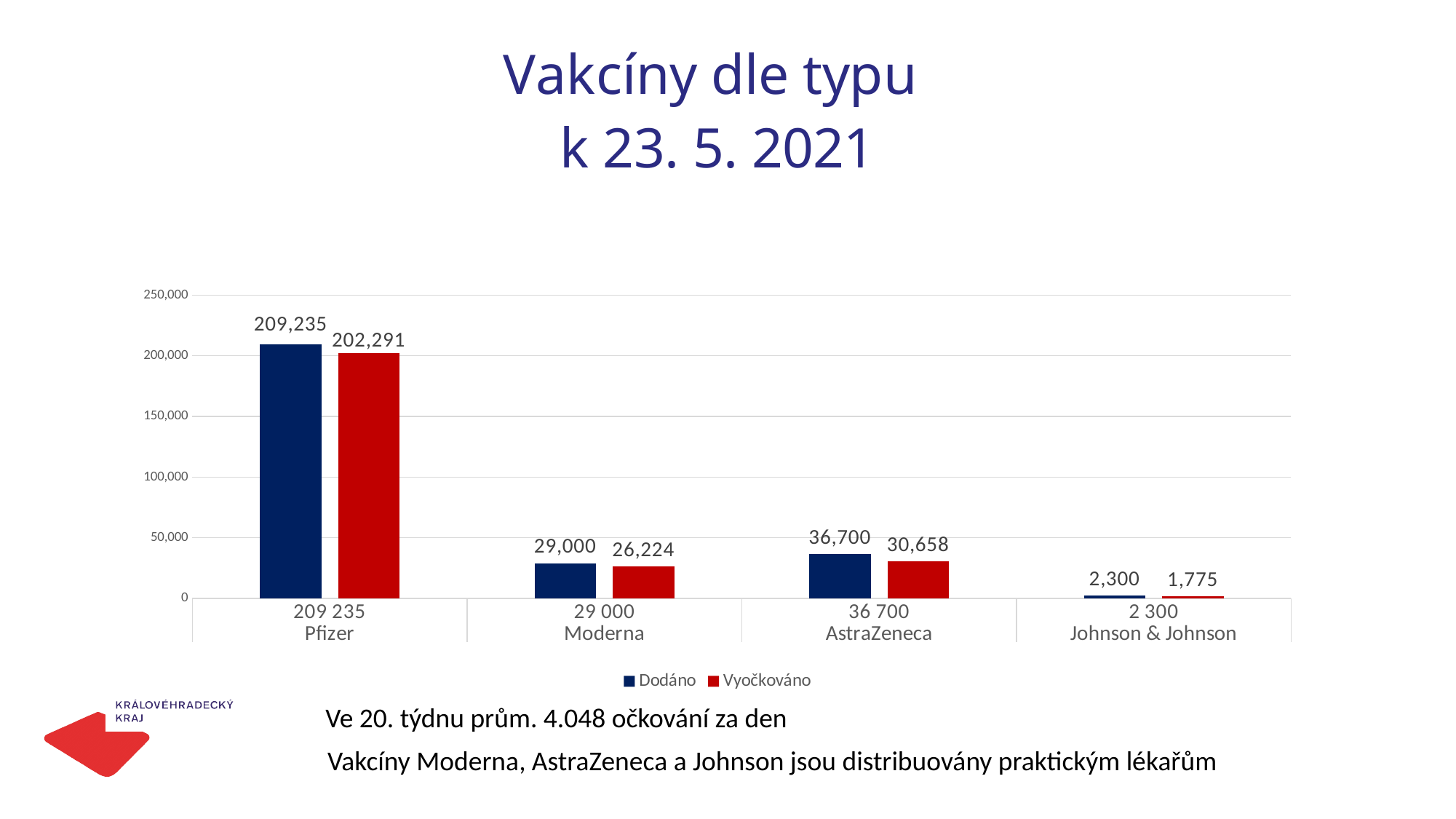
What is the difference between the Dodáno values for AstraZeneca and Moderna? 7,700 How many vaccine types are shown on the x axis? 4 Which vaccine has the lowest Vyočkováno value? Johnson & Johnson What is the Dodáno value for Pfizer? 209,235 What is the Vyočkováno value for AstraZeneca? 30,658 How many series does the legend list? 2 What is the difference between the Dodáno and Vyočkováno values for Pfizer? 6,944 What is the Dodáno value for Moderna? 29,000 Which vaccine has the highest Dodáno value? Pfizer Which is larger, the Vyočkováno value for AstraZeneca or for Moderna? AstraZeneca What kind of chart is shown on the slide? Bar chart What is the Vyočkováno value for Johnson & Johnson? 1,775